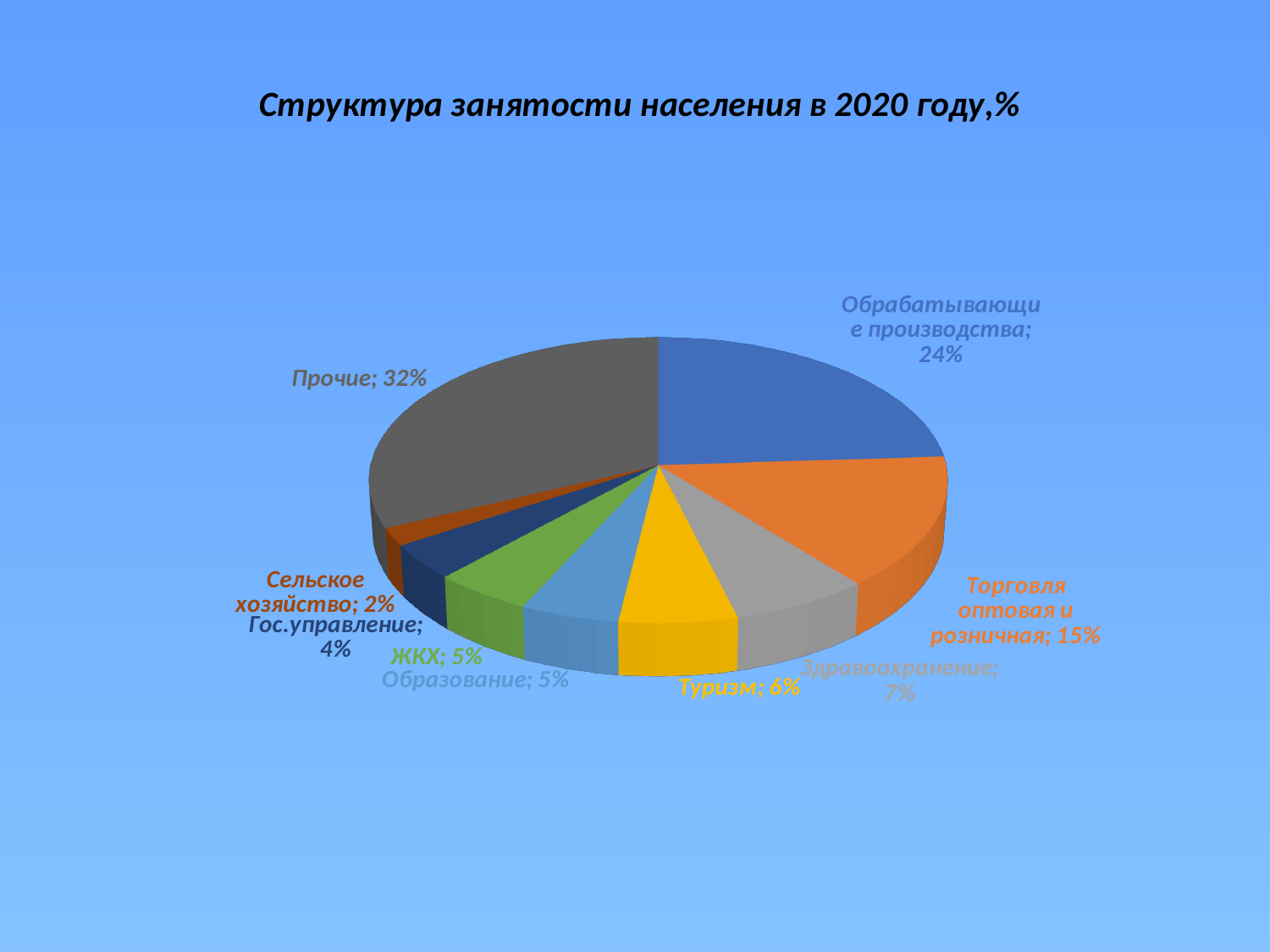
Which is larger, the share of Туризм or the share of Гос.управление? Туризм Which category has the largest slice of the pie? Прочие What is the value shown for Торговля оптовая и розничная? 15% Which category has the smallest slice of the pie? Сельское хозяйство What share does Обрабатывающие производства have in the pie chart? 24% What is the difference between the shares of Прочие and Обрабатывающие производства? 8% What is the combined share of Образование and ЖКХ? 10% What is the title of the chart? Структура занятости населения в 2020 году,% What type of chart is shown on the slide? pie chart What is the value shown for Здравоохранение? 7% What is the value shown for Сельское хозяйство? 2% How many categories are shown in the pie chart? 9